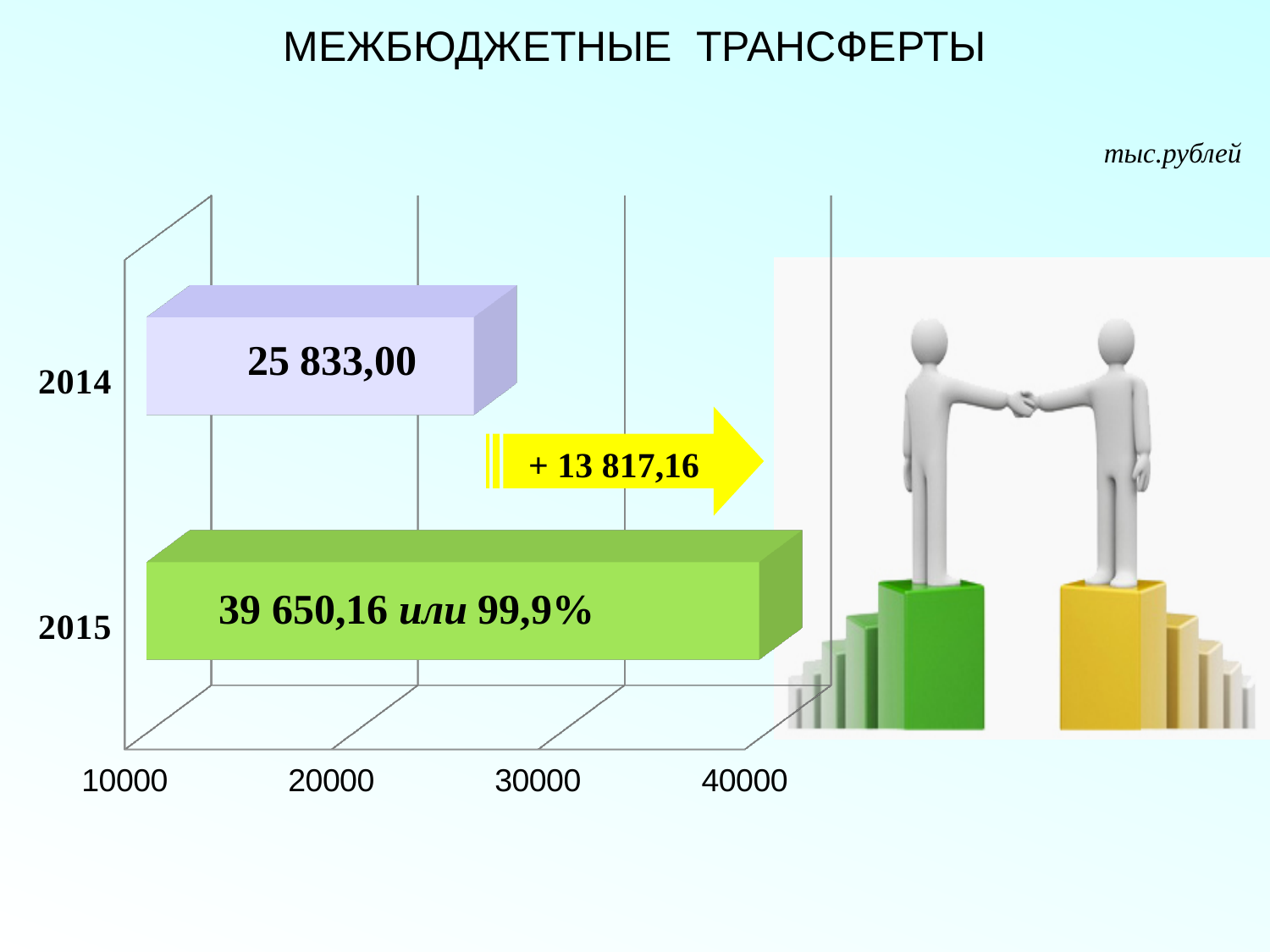
Is the value for 2015 greater or less than 30000? greater Which year has the highest value on the chart? 2015 Which year has the higher value, 2014 or 2015? 2015 What unit of measurement is indicated for the chart values? тыс.рублей What is the value shown for 2014? 25 833,00 What is the value shown for 2015? 39 650,16 What is the title of the slide's chart? МЕЖБЮДЖЕТНЫЕ ТРАНСФЕРТЫ Is the value for 2014 greater or less than 20000? greater What is the difference between the 2015 value and the 2014 value? 13 817,16 What kind of chart is shown on the slide? Bar chart How many years (categories) are plotted on the chart? 2 Which year has the lowest value on the chart? 2014